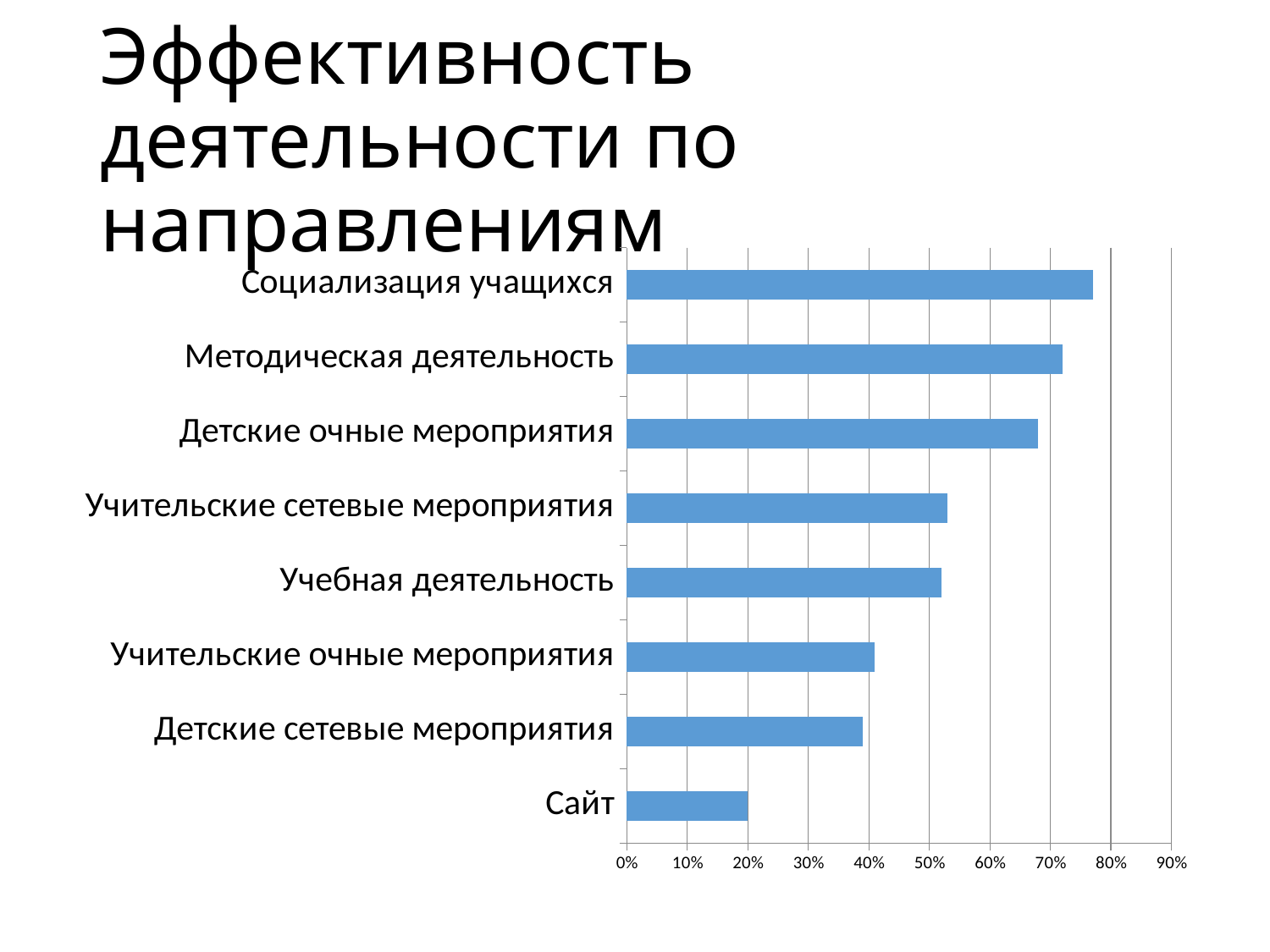
Is the value for Методическая деятельность greater or less than 60%? greater Is the value for Учительские очные мероприятия greater or less than 50%? less What is the title of the slide containing the chart? Эффективность деятельности по направлениям How many categories are plotted in the chart? 8 What kind of chart is shown on the slide? bar chart Is the value for Учительские сетевые мероприятия greater or less than 50%? greater Which category has the highest value in the chart? Социализация учащихся Which has a larger value: Детские очные мероприятия or Учительские очные мероприятия? Детские очные мероприятия Which category has the lowest value in the chart? Сайт What is the maximum value shown on the horizontal axis of the chart? 90% Which has a larger value: Сайт or Детские сетевые мероприятия? Детские сетевые мероприятия